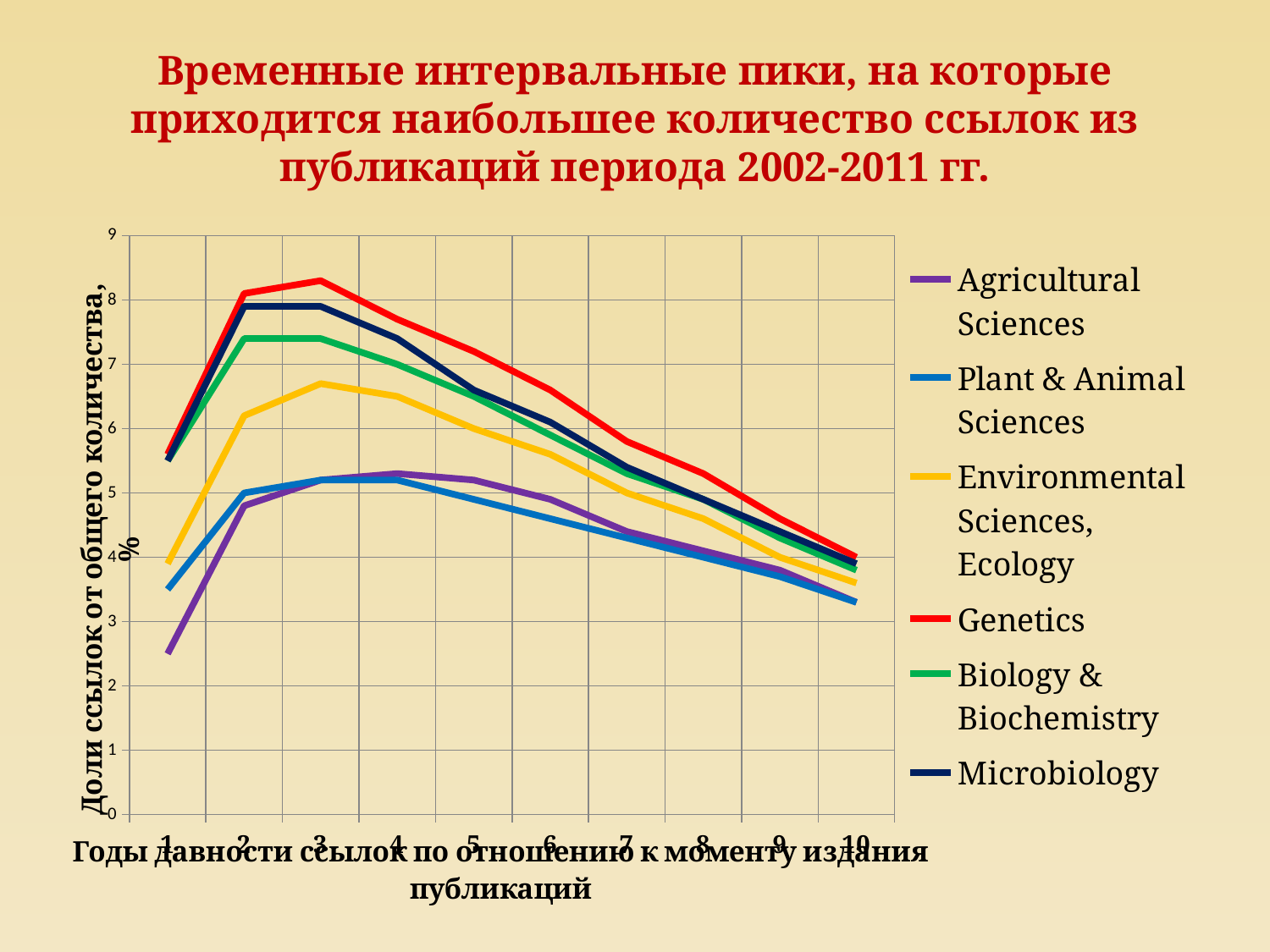
Is the value for Agricultural Sciences at year 1 greater or less than 3? less Is the value for Genetics at year 3 greater or less than 8? greater At year 2, which is larger: Genetics or Environmental Sciences, Ecology? Genetics Which series has the highest value at year 3? Genetics Which series has the lowest value at year 1? Agricultural Sciences Which series is listed first in the legend? Agricultural Sciences Do the values for Genetics rise or fall from year 3 to year 10? fall What colour is the Genetics line? red What kind of chart is shown on the slide? line chart Is the value for Plant & Animal Sciences at year 10 greater or less than 4? less How many points (years) are plotted along the x axis? 10 How many series does the legend list? 6